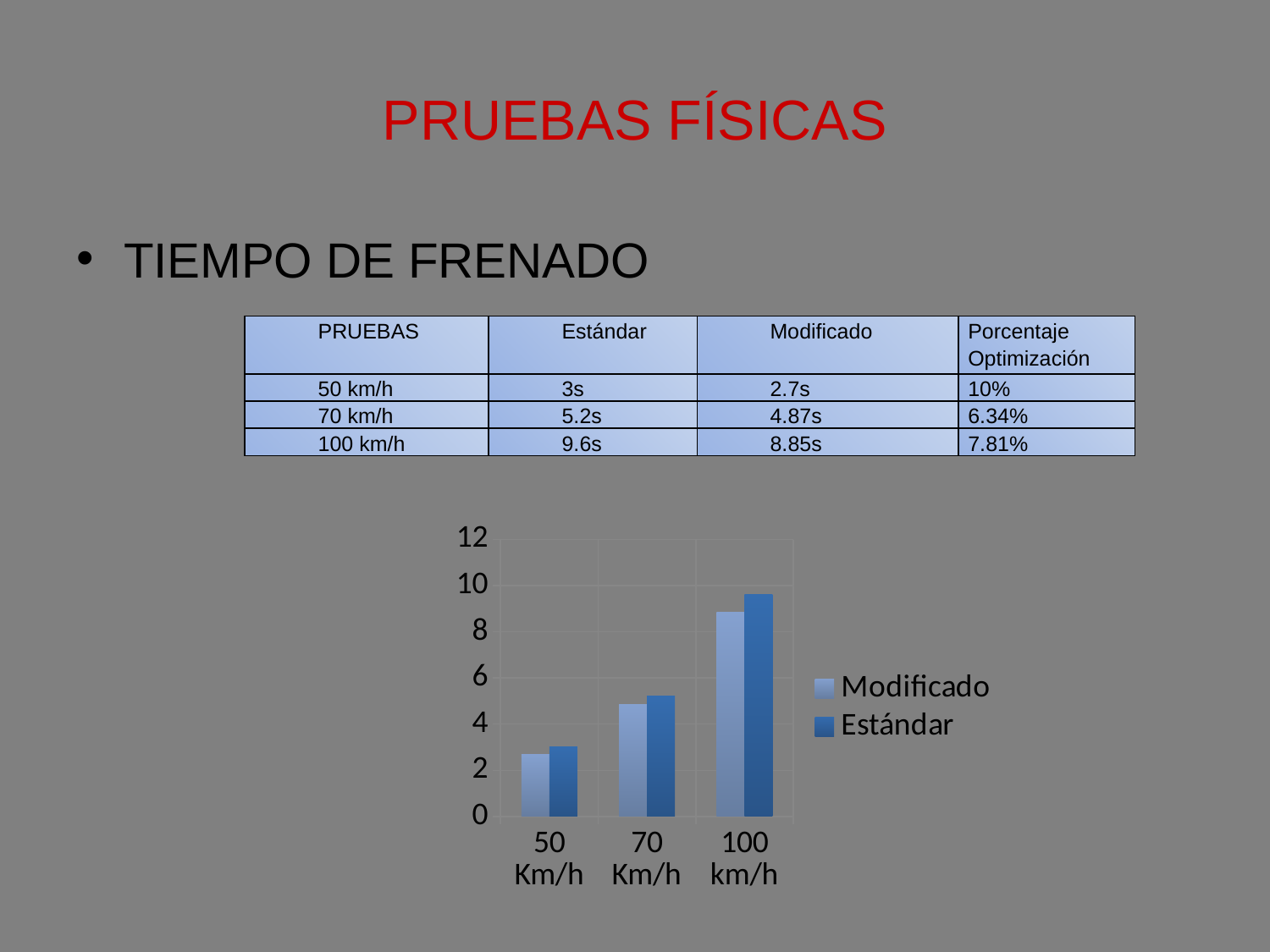
Which category has the lowest Modificado bar in the chart? 50 Km/h What are the two legend entries of the chart? Modificado, Estándar Do the Modificado bars rise or fall from 50 Km/h to 100 km/h? rise What kind of chart is shown on the slide? bar chart What is the highest value shown on the chart's vertical axis? 12 Is the Estándar value for 70 Km/h greater or less than 6? less How many series does the chart legend list? 2 Is the Modificado value for 50 Km/h greater or less than 4? less How many categories are shown on the x axis of the chart? 3 Which category has the highest Estándar bar in the chart? 100 km/h Is the Estándar value for 100 km/h greater or less than 8? greater For 100 km/h, which is larger in the chart: Modificado or Estándar? Estándar